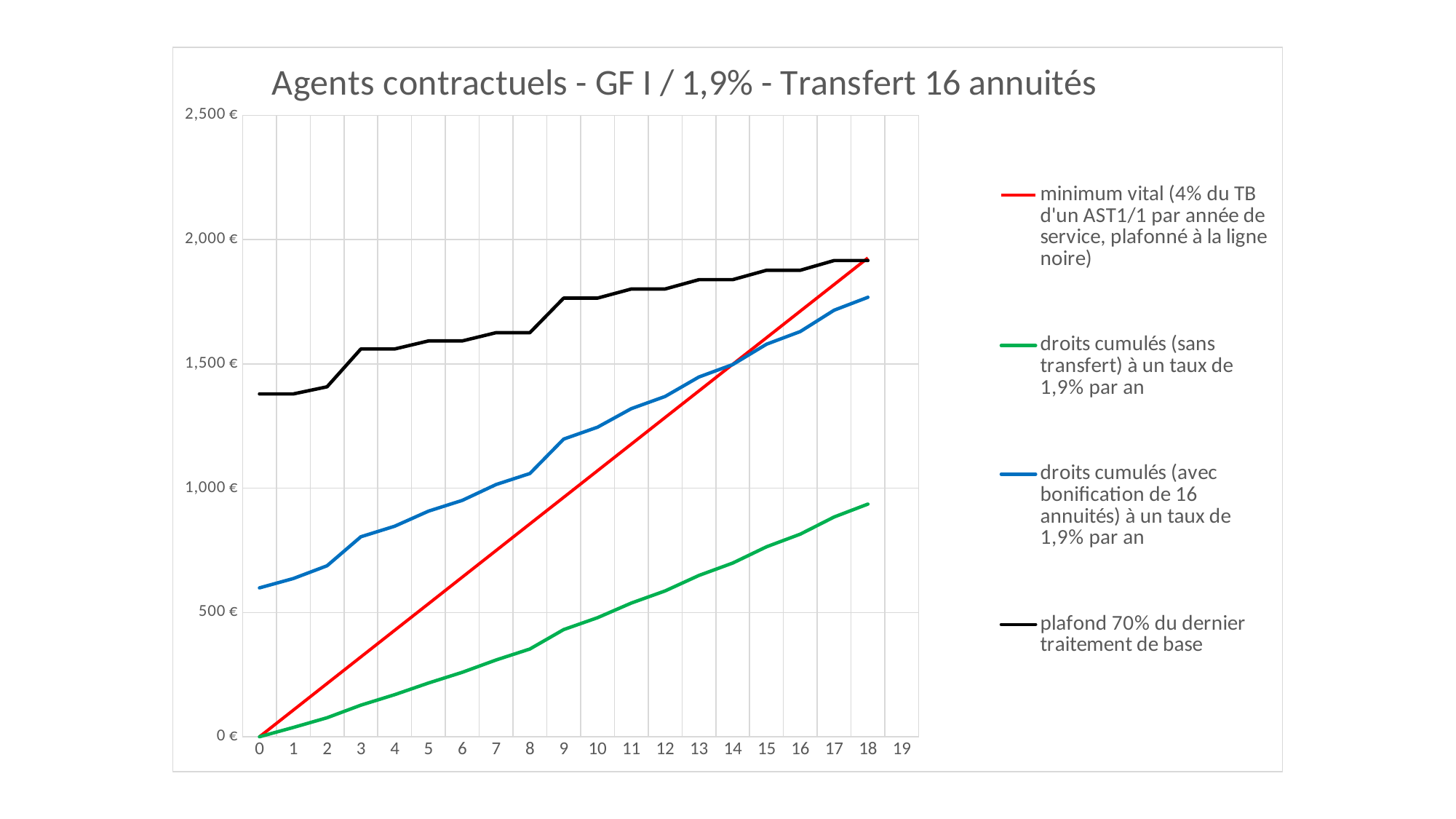
What is the title of the chart? Agents contractuels - GF I / 1,9% - Transfert 16 annuités At year 18, which is larger: the red line or the blue line? the red line What kind of chart is shown on the slide? line chart Is the value of the blue line (droits cumulés avec bonification) at year 18 greater or less than 1,500 €? greater Is the value of the green line (droits cumulés sans transfert) at year 8 greater or less than 500 €? less Does the red line (minimum vital) rise or fall as the years increase? rise Is the value of the black line (plafond 70%) at year 0 greater or less than 1,500 €? less Which series has the lowest value at year 18? droits cumulés (sans transfert) à un taux de 1,9% par an Which colour is the line for "plafond 70% du dernier traitement de base"? black At year 5, which is larger: the blue line or the green line? the blue line How many series does the legend list? 4